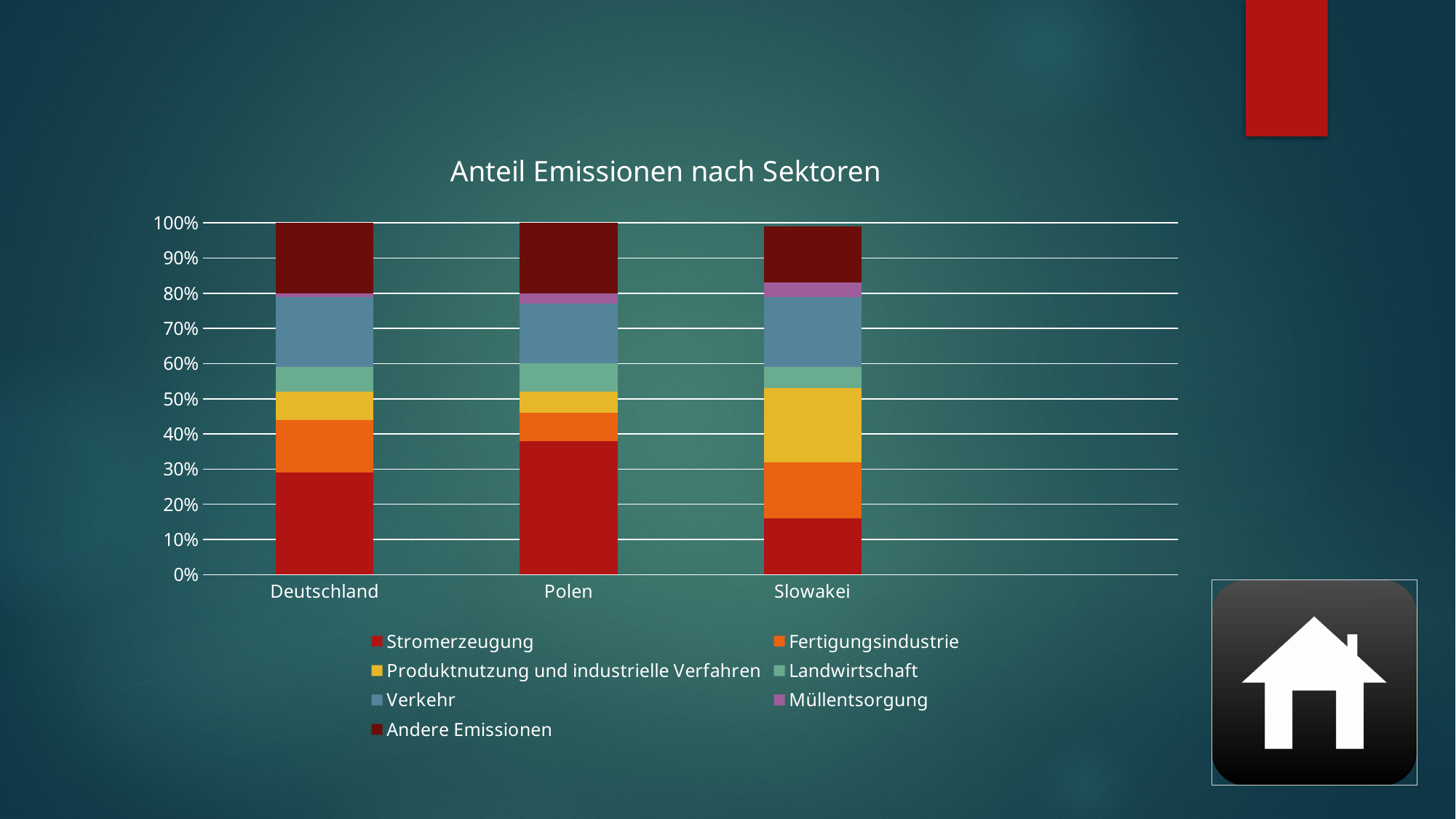
Is the Stromerzeugung share for Slowakei greater or less than 20%? less Which country has the largest Stromerzeugung share? Polen How many countries are shown on the x axis of the chart? 3 Which country has the smallest Fertigungsindustrie share? Polen Which country has the largest share for Produktnutzung und industrielle Verfahren? Slowakei Which is larger: the Stromerzeugung share for Polen or for Deutschland? Polen Which series is shown in purple in the legend? Müllentsorgung Is the Stromerzeugung share for Polen greater or less than 30%? greater How many series does the chart's legend list? 7 What kind of chart is shown on the slide? Stacked bar chart Which country has the smallest Stromerzeugung share? Slowakei What is the title of the chart? Anteil Emissionen nach Sektoren